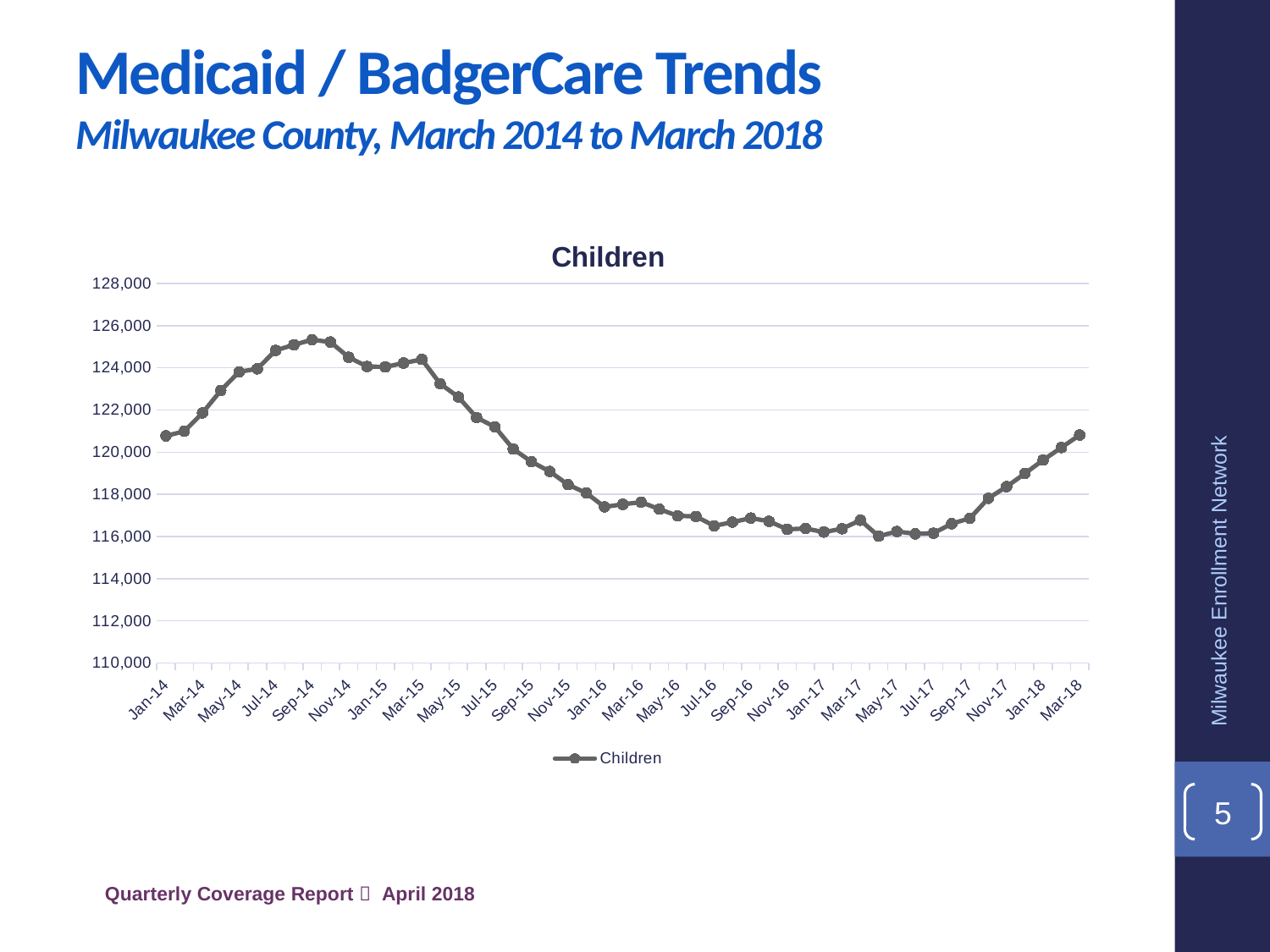
Is the value for Jan-14 greater or less than 120,000? greater Is the value for Jul-16 greater or less than 118,000? less Is the value for Mar-18 greater or less than 120,000? greater Which is larger, the value for Jan-14 or the value for Jan-16? Jan-14 What is the title of the chart? Children Do the values rise or fall between Jul-17 and Mar-18? rise What kind of chart is shown on the slide? line chart How many series does the legend list? 1 Do the values rise or fall between Mar-15 and Jan-16? fall What is the first month shown on the x axis of the chart? Jan-14